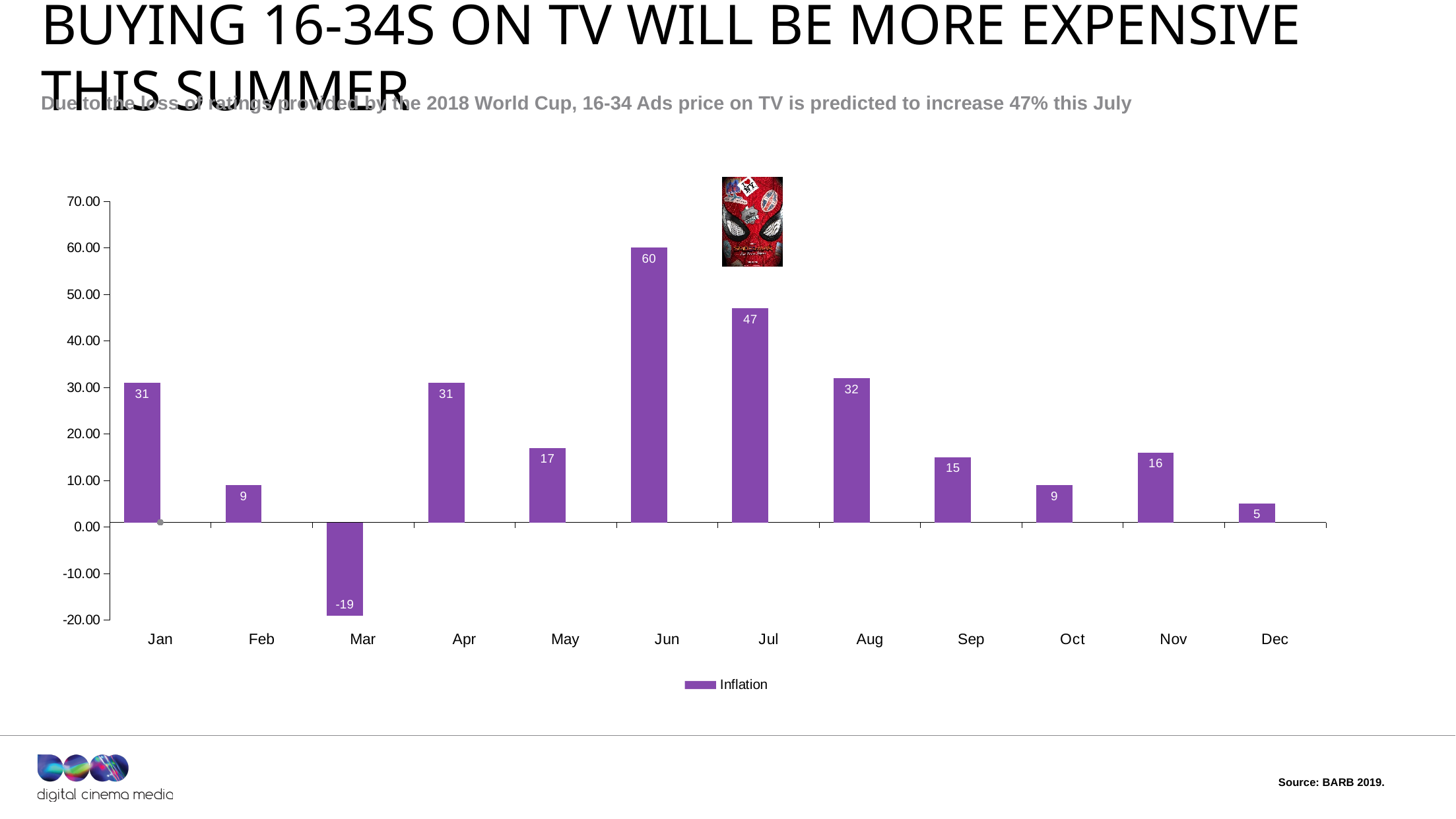
Which has a larger Inflation value, Aug or Apr? Aug What is the difference between the Inflation values for Jun and Jul? 13 Which month has the highest Inflation value? Jun What is the name of the series shown in the legend? Inflation What kind of chart is shown on the slide? bar chart What is the Inflation value for Jul? 47 Is the Inflation value for Jun greater or less than 50.00? greater How many months are shown on the x axis? 12 What is the Inflation value for Mar? -19 How many series does the legend list? 1 Which month has the lowest Inflation value? Mar What is the Inflation value for Dec? 5